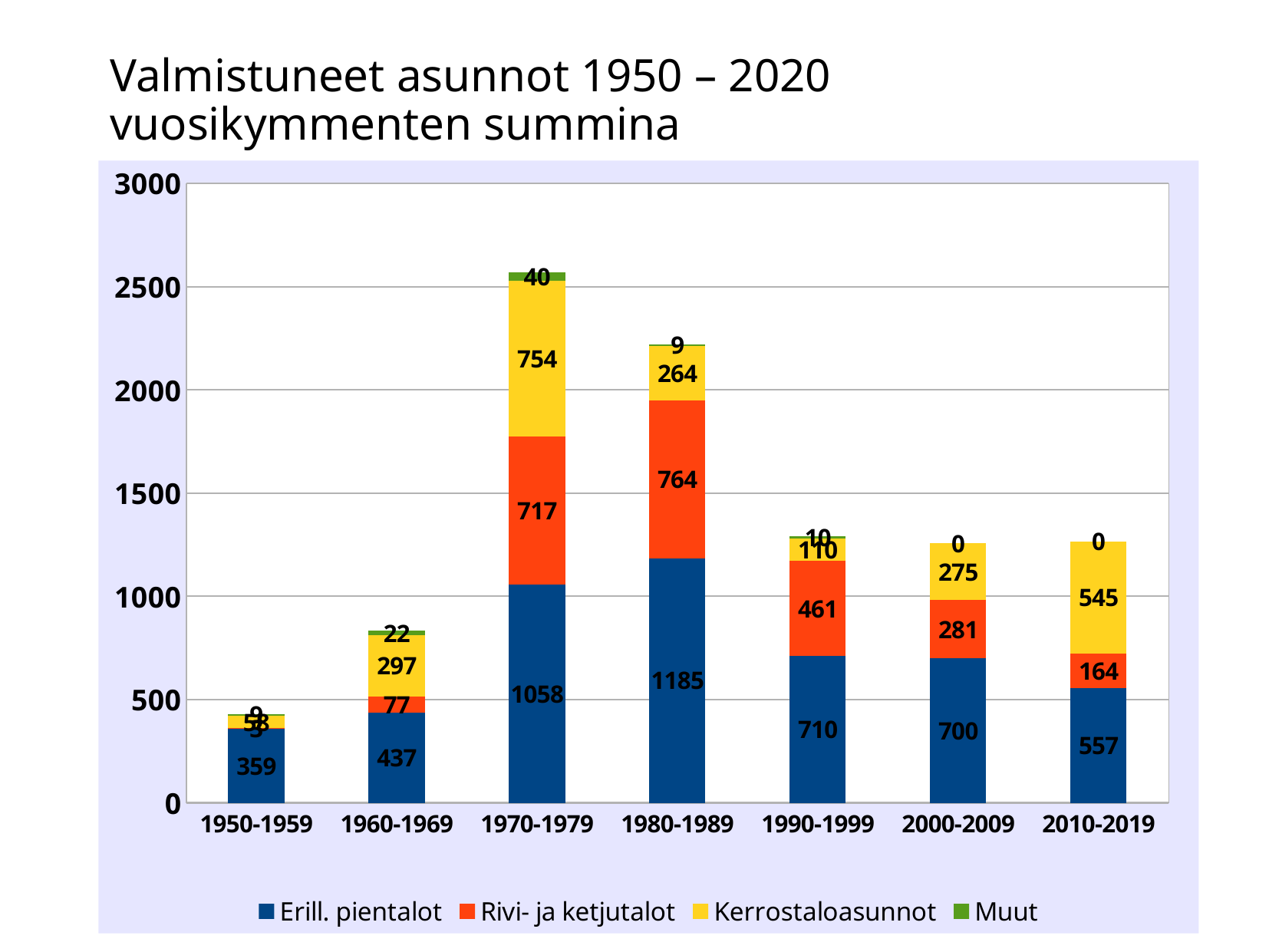
What is the value for Kerrostaloasunnot in 2010-2019? 545 What is the difference between the Rivi- ja ketjutalot values for 1980-1989 and 1990-1999? 303 What is the total of the stacked bar for 2000-2009? 1256 What is the value for Erill. pientalot in 1980-1989? 1185 Which decade has the lowest value for Erill. pientalot? 1950-1959 How many series does the legend list? 4 What is the value for Rivi- ja ketjutalot in 1970-1979? 717 Is the total of the stacked bar for 1970-1979 greater or less than 2500? greater What kind of chart is shown on the slide? Stacked bar chart How many decades are shown on the x axis? 7 Which decade has the larger Kerrostaloasunnot value, 1970-1979 or 1980-1989? 1970-1979 Which decade has the highest value for Erill. pientalot? 1980-1989